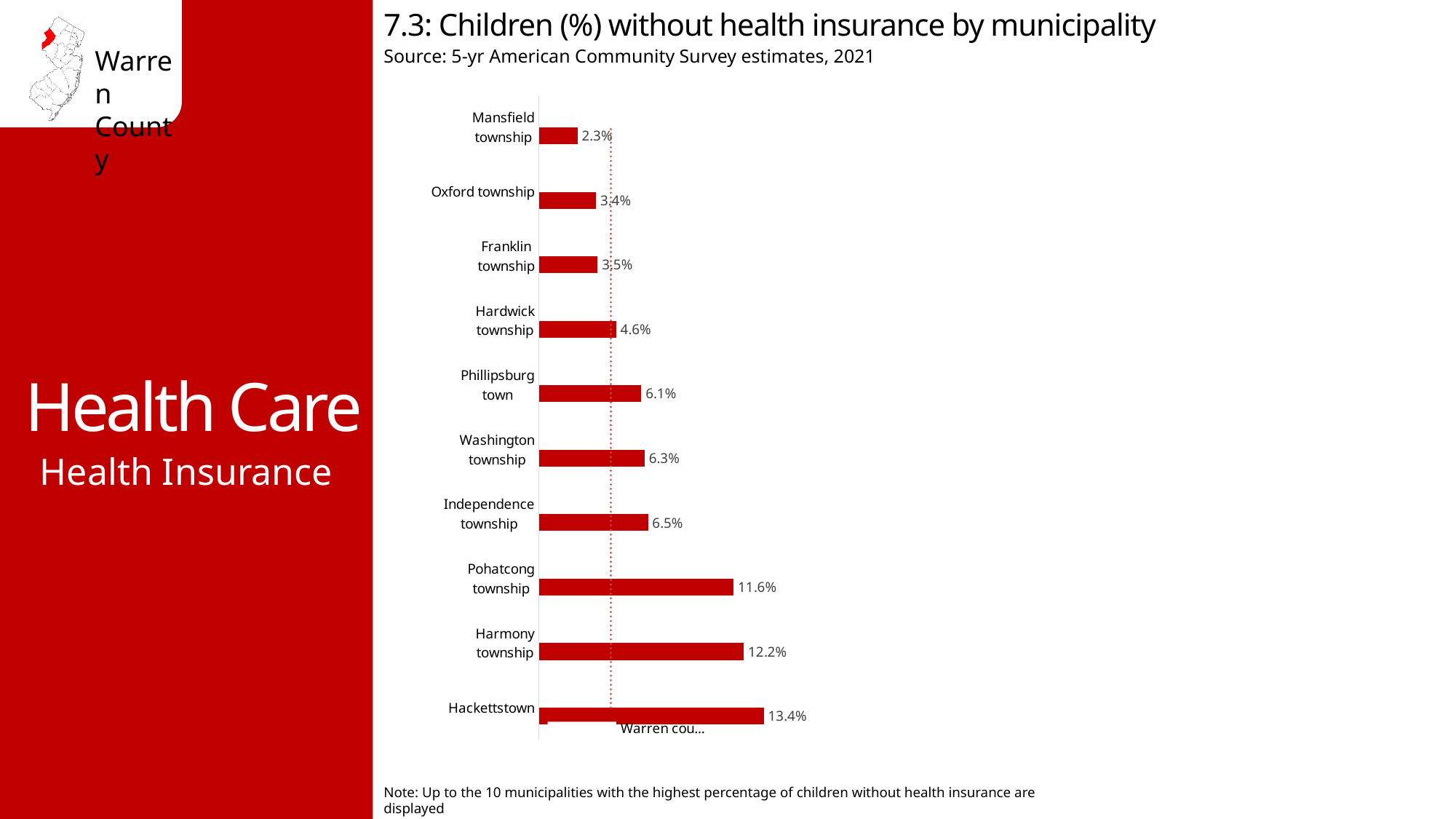
Which has a higher value, Washington township or Hardwick township? Washington township Which municipality has the highest percentage of children without health insurance? Hackettstown What kind of chart is shown on the slide? Bar chart What is the difference between the values for Hackettstown and Mansfield township? 11.1% How many municipalities are shown in the chart? 10 What is the source cited for the chart? 5-yr American Community Survey estimates, 2021 Which municipality has the lowest percentage of children without health insurance? Mansfield township What percentage of children are without health insurance in Hackettstown? 13.4% What is the value shown for Phillipsburg town? 6.1% What is the difference between the values for Harmony township and Pohatcong township? 0.6% What is the value shown for Mansfield township? 2.3% What is the value shown for Pohatcong township? 11.6%